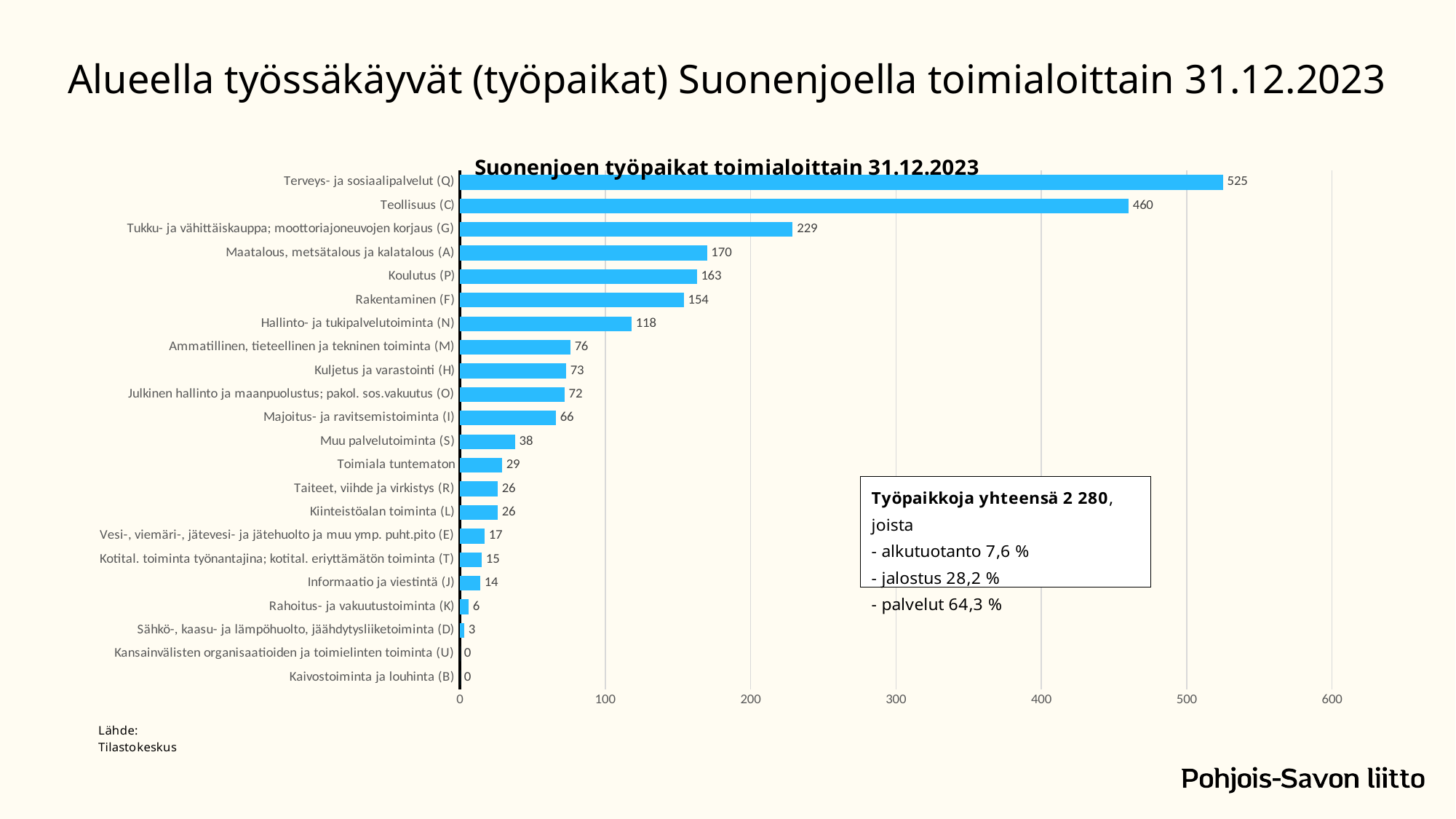
What is the value for Sähkö-, kaasu- ja lämpöhuolto, jäähdytysliiketoiminta (D)? 3 What is the value for Koulutus (P)? 163 How many categories are shown in the chart? 22 What is the title of the chart? Suonenjoen työpaikat toimialoittain 31.12.2023 What is the difference between Terveys- ja sosiaalipalvelut (Q) and Teollisuus (C)? 65 What is the value for Hallinto- ja tukipalvelutoiminta (N)? 118 Is the value for Tukku- ja vähittäiskauppa; moottoriajoneuvojen korjaus (G) greater or less than 200? greater What is the value for Teollisuus (C)? 460 What kind of chart is shown on the slide? bar chart Which category has the highest value? Terveys- ja sosiaalipalvelut (Q) Which is larger, Kuljetus ja varastointi (H) or Majoitus- ja ravitsemistoiminta (I)? Kuljetus ja varastointi (H) What is the difference between Rakentaminen (F) and Maatalous, metsätalous ja kalatalous (A)? 16